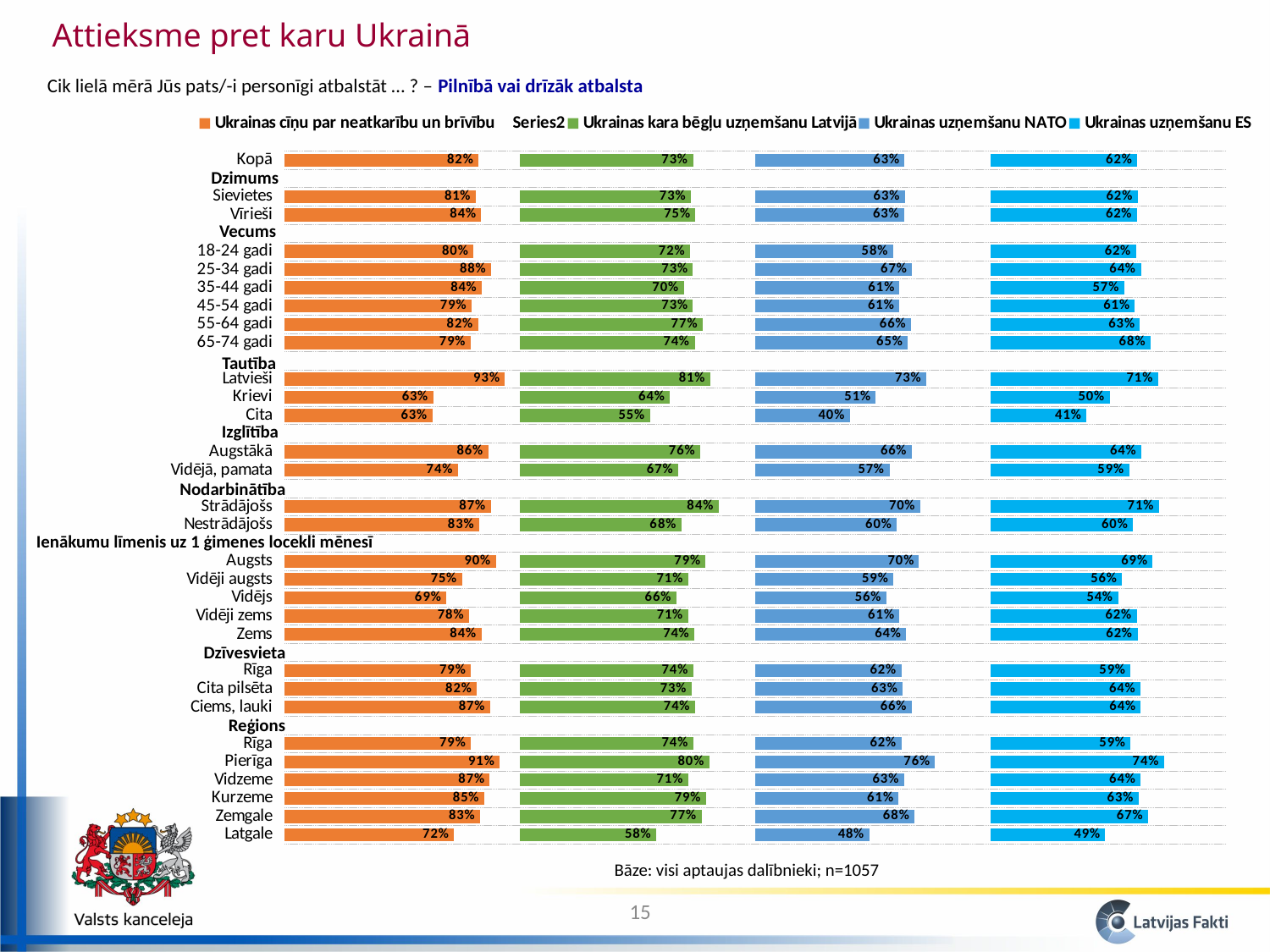
What is the difference between Sievietes and Vīrieši in the series Ukrainas cīņu par neatkarību un brīvību? 3% What kind of chart is shown on the slide? Bar chart Among the Tautība categories (Latvieši, Krievi, Cita), which has the highest value in the series Ukrainas cīņu par neatkarību un brīvību? Latvieši What is the value for Pierīga in the series Ukrainas uzņemšanu ES? 74% What is the difference between Latvieši and Krievi in the series Ukrainas uzņemšanu NATO? 22% What is the value for Kopā in the series Ukrainas cīņu par neatkarību un brīvību? 82% What is the value for Strādājošs in the series Ukrainas kara bēgļu uzņemšanu Latvijā? 84% Among the Reģions categories, which has the lowest value in the series Ukrainas uzņemšanu ES? Latgale What is the value for Cita (Tautība) in the series Ukrainas kara bēgļu uzņemšanu Latvijā? 55% What colour are the bars for the series Ukrainas cīņu par neatkarību un brīvību? Orange What is the value for Latgale in the series Ukrainas uzņemšanu NATO? 48% Which is larger for Augsts: the value in Ukrainas uzņemšanu NATO or the value in Ukrainas uzņemšanu ES? Ukrainas uzņemšanu NATO